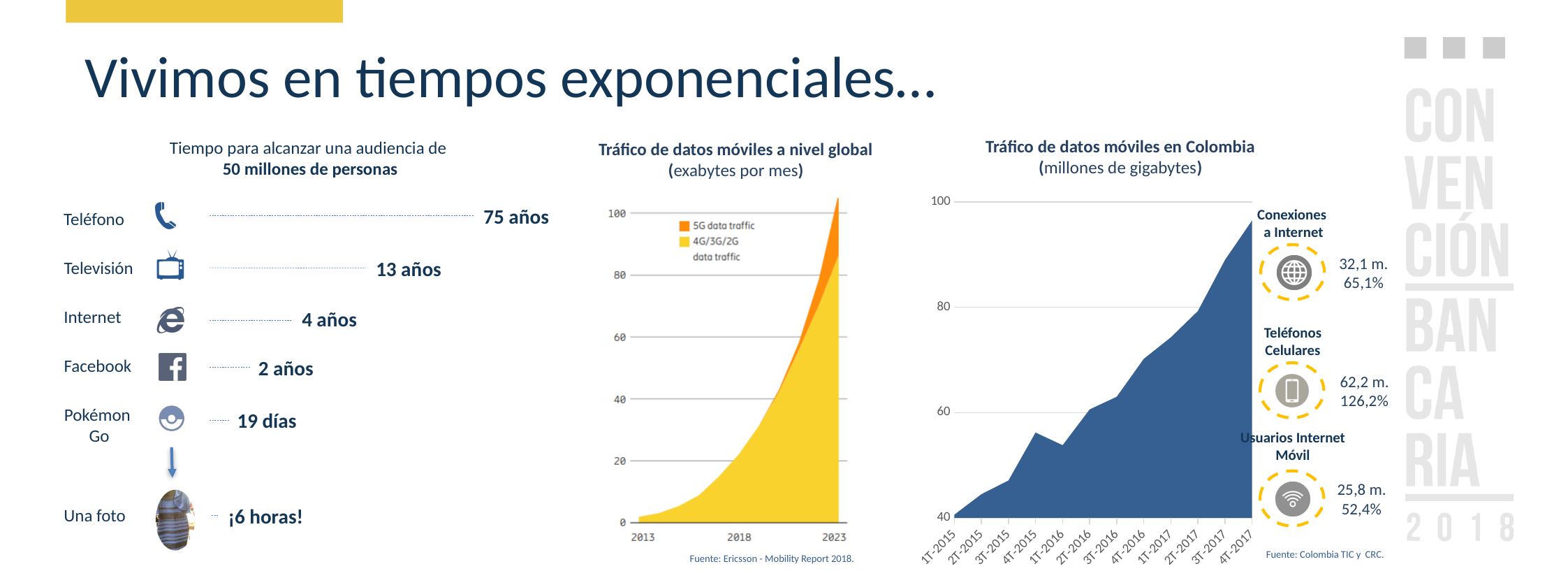
In the 'Tráfico de datos móviles en Colombia' chart, is the value for 4T-2017 greater or less than 80? greater Which series in the 'Tráfico de datos móviles a nivel global' chart is shown in orange? 5G data traffic How many series does the legend of the 'Tráfico de datos móviles a nivel global' chart list? 2 In the 'Tráfico de datos móviles en Colombia' chart, which quarter has the lowest value? 1T-2015 In the 'Tráfico de datos móviles en Colombia' chart, which is larger, the value for 1T-2017 or the value for 1T-2016? 1T-2017 In the 'Tráfico de datos móviles a nivel global' chart, is the total traffic in 2023 greater or less than 80? greater In the 'Tráfico de datos móviles a nivel global' chart, is the total traffic in 2018 greater or less than 40? less How many quarters are plotted on the x axis of the 'Tráfico de datos móviles en Colombia' chart? 12 In the 'Tráfico de datos móviles a nivel global' chart, do the values rise or fall from 2013 to 2023? Rise In the 'Tráfico de datos móviles en Colombia' chart, which quarter has the highest value? 4T-2017 What kind of chart is 'Tráfico de datos móviles a nivel global'? Area chart